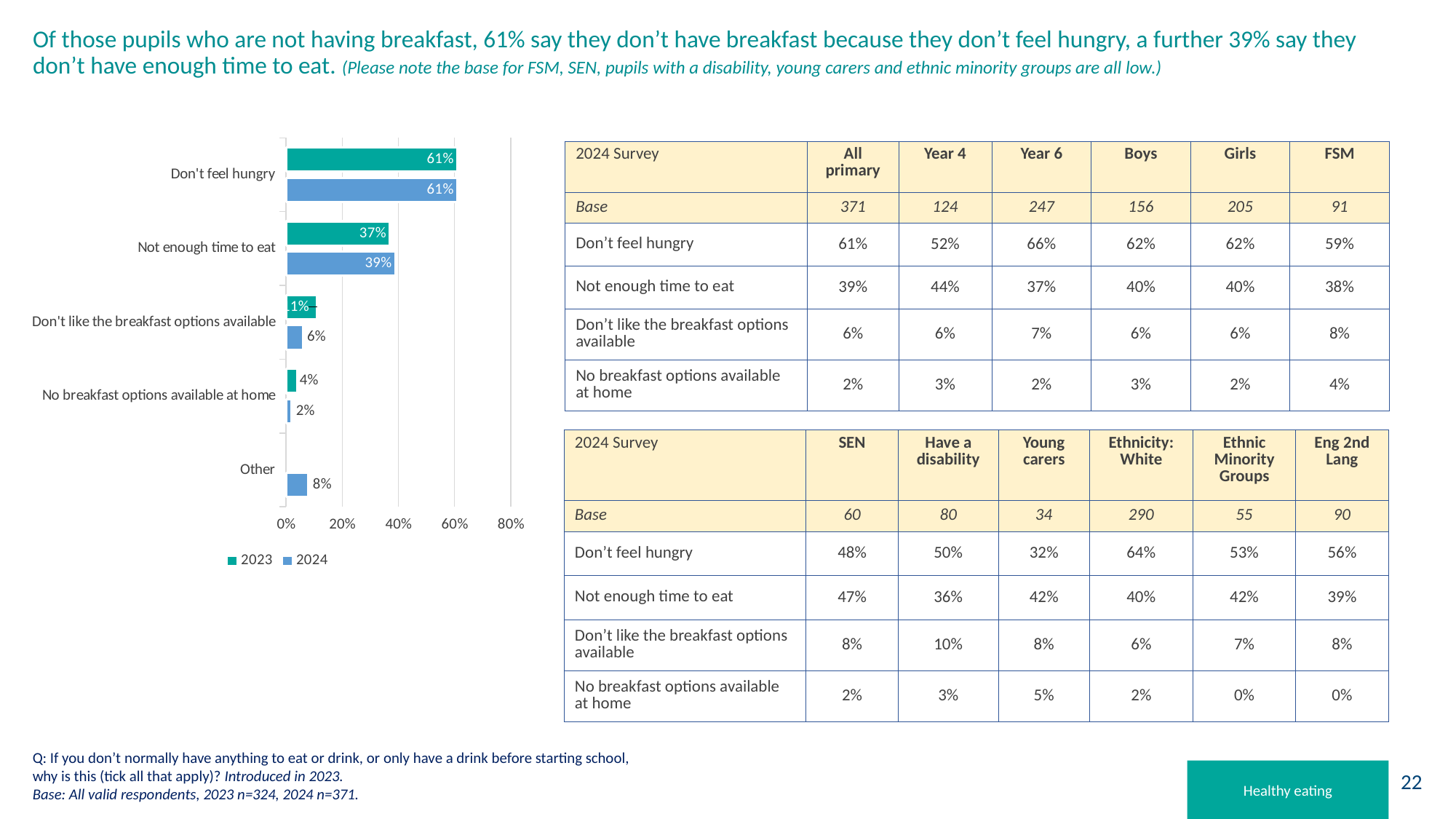
What kind of chart is shown on the left of the slide? bar chart What is the 2024 value for 'Not enough time to eat' in the chart? 39% What is the 2023 value for 'Not enough time to eat' in the chart? 37% How many series does the chart legend list? 2 Which category has the highest 2024 value in the chart? Don't feel hungry How many categories are shown on the chart's vertical axis? 5 What is the 2024 value for 'Don't feel hungry' in the chart? 61% What is the 2024 value for 'Other' in the chart? 8% Which colour represents the 2024 series in the chart? blue What is the 2023 value for 'No breakfast options available at home' in the chart? 4% What is the difference between the 2024 and 2023 values for 'Not enough time to eat'? 2% For 'No breakfast options available at home', which year has the larger value, 2023 or 2024? 2023